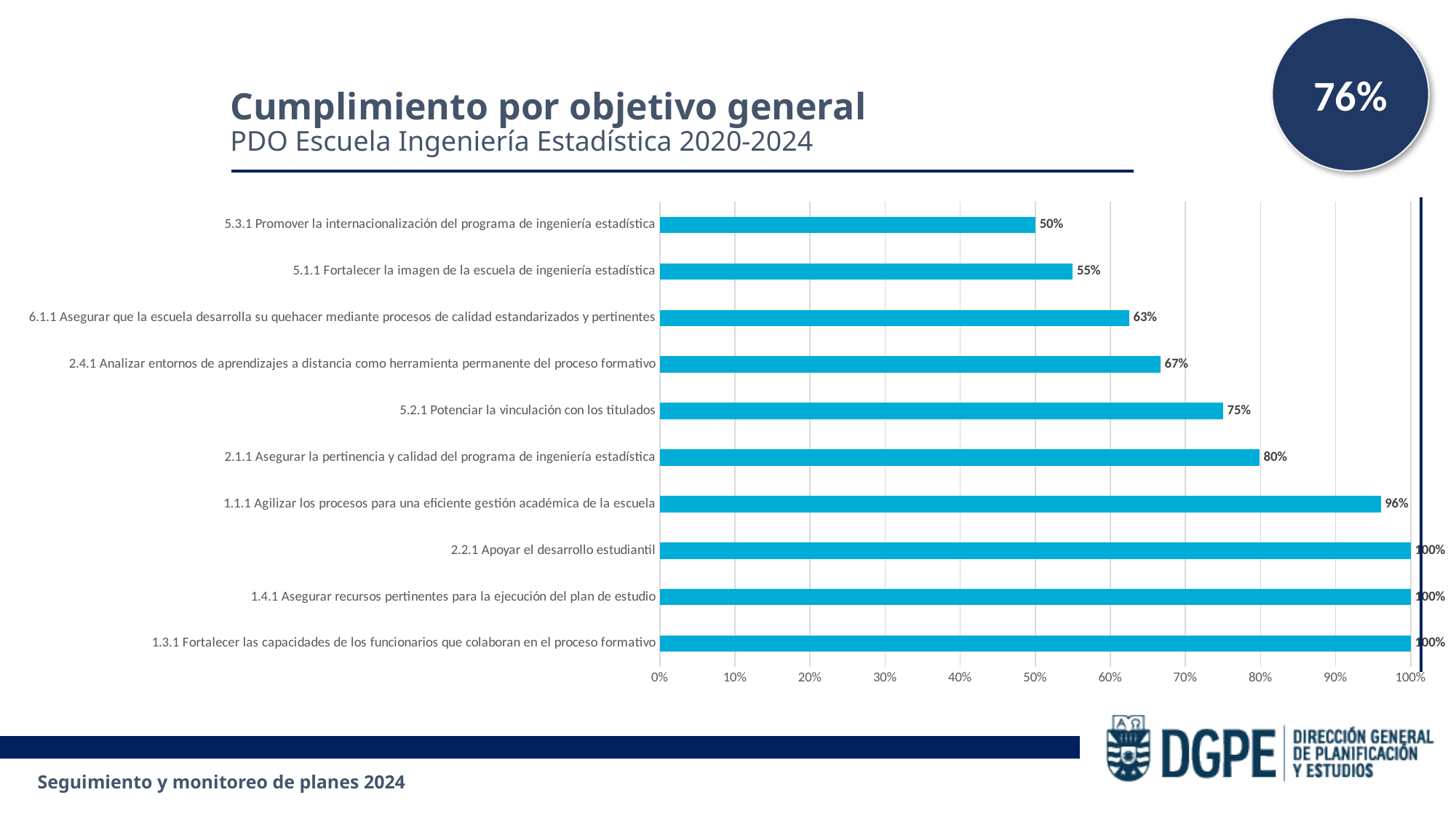
What kind of chart is shown on the slide? bar chart What is the value for 5.3.1 Promover la internacionalización del programa de ingeniería estadística? 50% How many objectives reach 100%? 3 Which objective has the lowest value? 5.3.1 Promover la internacionalización del programa de ingeniería estadística Which is larger, the value for 6.1.1 Asegurar que la escuela desarrolla su quehacer mediante procesos de calidad estandarizados y pertinentes or the value for 5.2.1 Potenciar la vinculación con los titulados? 5.2.1 Potenciar la vinculación con los titulados How many objectives are plotted in the chart? 10 What is the value for 5.2.1 Potenciar la vinculación con los titulados? 75% What is the value for 1.1.1 Agilizar los procesos para una eficiente gestión académica de la escuela? 96% What is the value for 2.4.1 Analizar entornos de aprendizajes a distancia como herramienta permanente del proceso formativo? 67% What is the difference between the values for 2.1.1 Asegurar la pertinencia y calidad del programa de ingeniería estadística and 5.1.1 Fortalecer la imagen de la escuela de ingeniería estadística? 25% What is the title of the chart? Cumplimiento por objetivo general Is the value for 5.1.1 Fortalecer la imagen de la escuela de ingeniería estadística greater or less than 60%? less